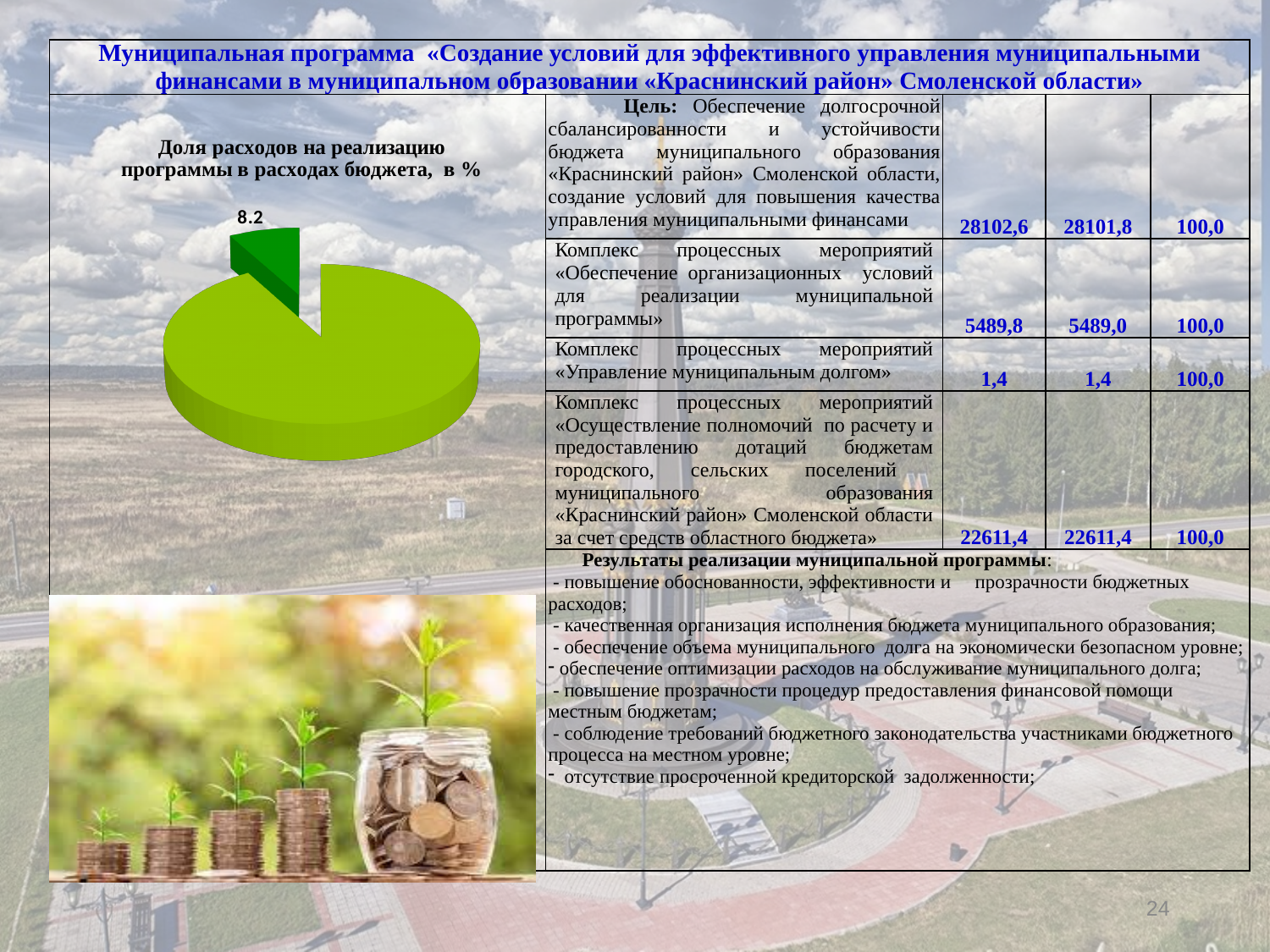
How many slices does the pie chart have? 2 What kind of chart is shown on the slide? pie chart What colour is the exploded slice labelled 8.2 in the pie chart? dark green What value is printed on the small exploded slice of the pie chart? 8.2 Is the value of the dark green exploded slice greater or less than 10? less What is the title of the pie chart on the slide? Доля расходов на реализацию программы в расходах бюджета, в % Which slice of the pie chart is larger, the dark green exploded slice or the light green slice? the light green slice Which slice of the pie chart is the smallest? the dark green slice labelled 8.2